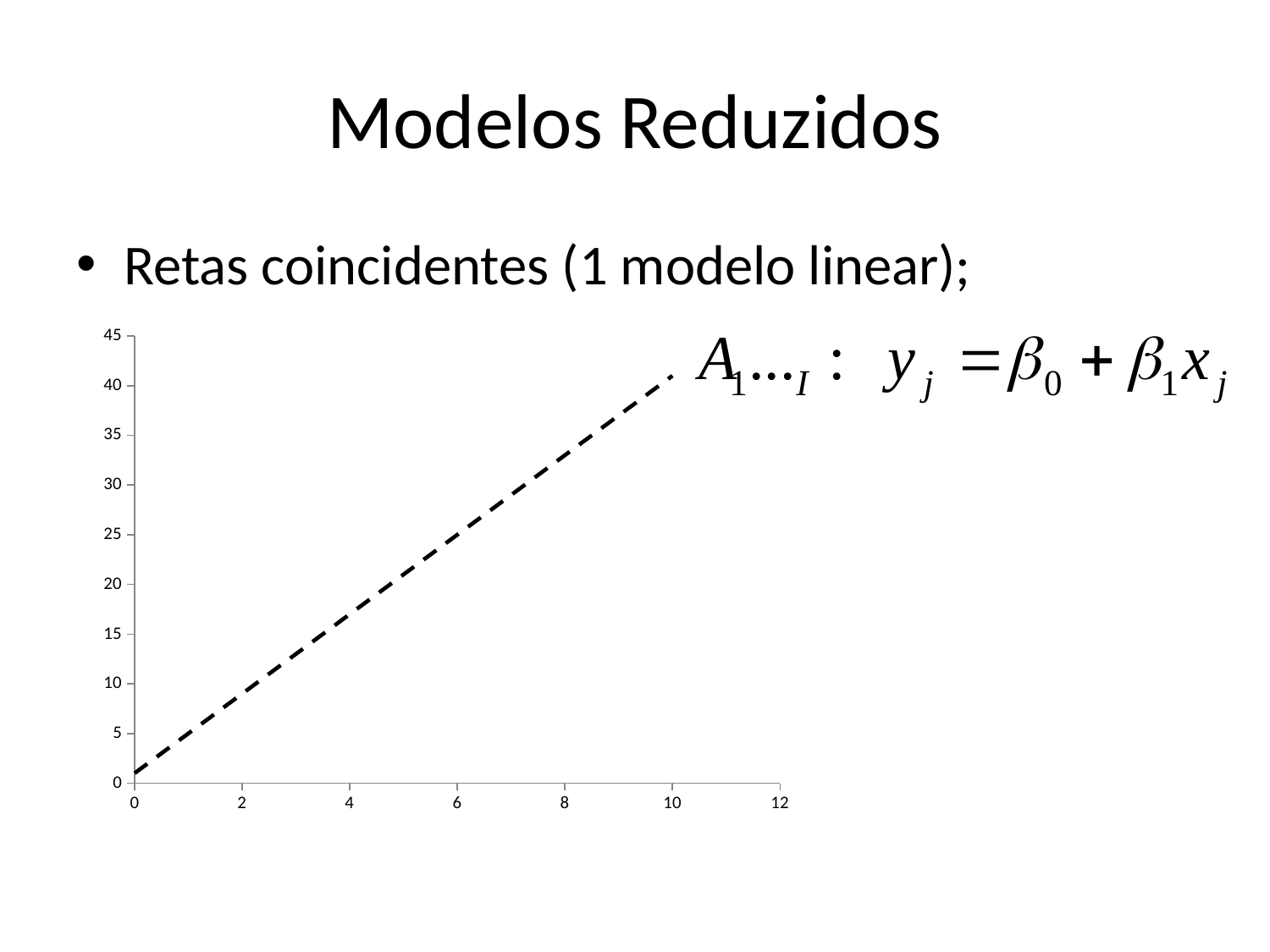
Do the values on the chart rise or fall as x increases from 0 to 10? rise Is the value of the line at x = 2 greater or less than 5? greater Is the value of the line at x = 4 greater or less than 10? greater What kind of chart is shown on the slide? line chart Is the value of the line at x = 0 greater or less than 5? less What is the highest tick value shown on the vertical axis of the chart? 45 Is the line on the chart drawn as a solid or a dashed line? dashed